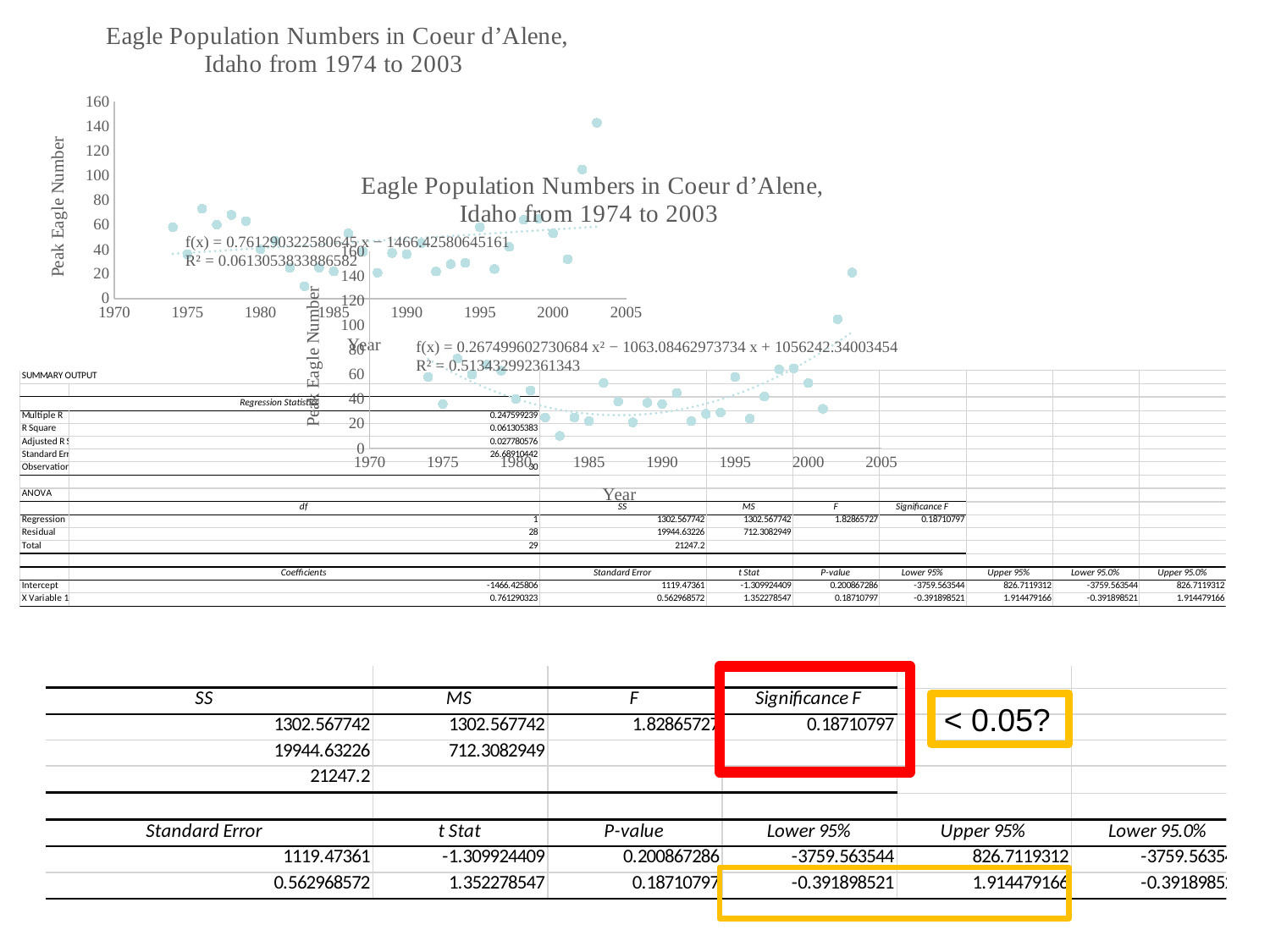
What is the R² value shown for the quadratic trendline on the lower-right chart? 0.513432992361343 What is the trendline equation shown on the lower-right chart? f(x) = 0.267499602730684 x² − 1063.08462973734 x + 1056242.34003454 On the top-left chart, what is the highest value shown on the y-axis? 160 On the top-left chart, does the linear trendline slope upward or downward across the years? upward On the top-left chart, is the lowest plotted point (around 1983) greater or less than 20? less Which chart has the higher R² value, the top-left chart with the linear trendline or the lower-right chart with the quadratic trendline? the lower-right chart with the quadratic trendline What is the trendline equation shown on the top-left chart? f(x) = 0.761290322580645x − 1466.42580645161 On the top-left chart, is the highest plotted point (around 2003) greater or less than 120? greater What is the y-axis label on the top-left chart? Peak Eagle Number What kind of chart is the top-left chart titled 'Eagle Population Numbers in Coeur d'Alene, Idaho from 1974 to 2003'? scatter chart What is the x-axis label on the lower-right chart? Year What is the R² value shown for the linear trendline on the top-left chart? 0.0613053833886582